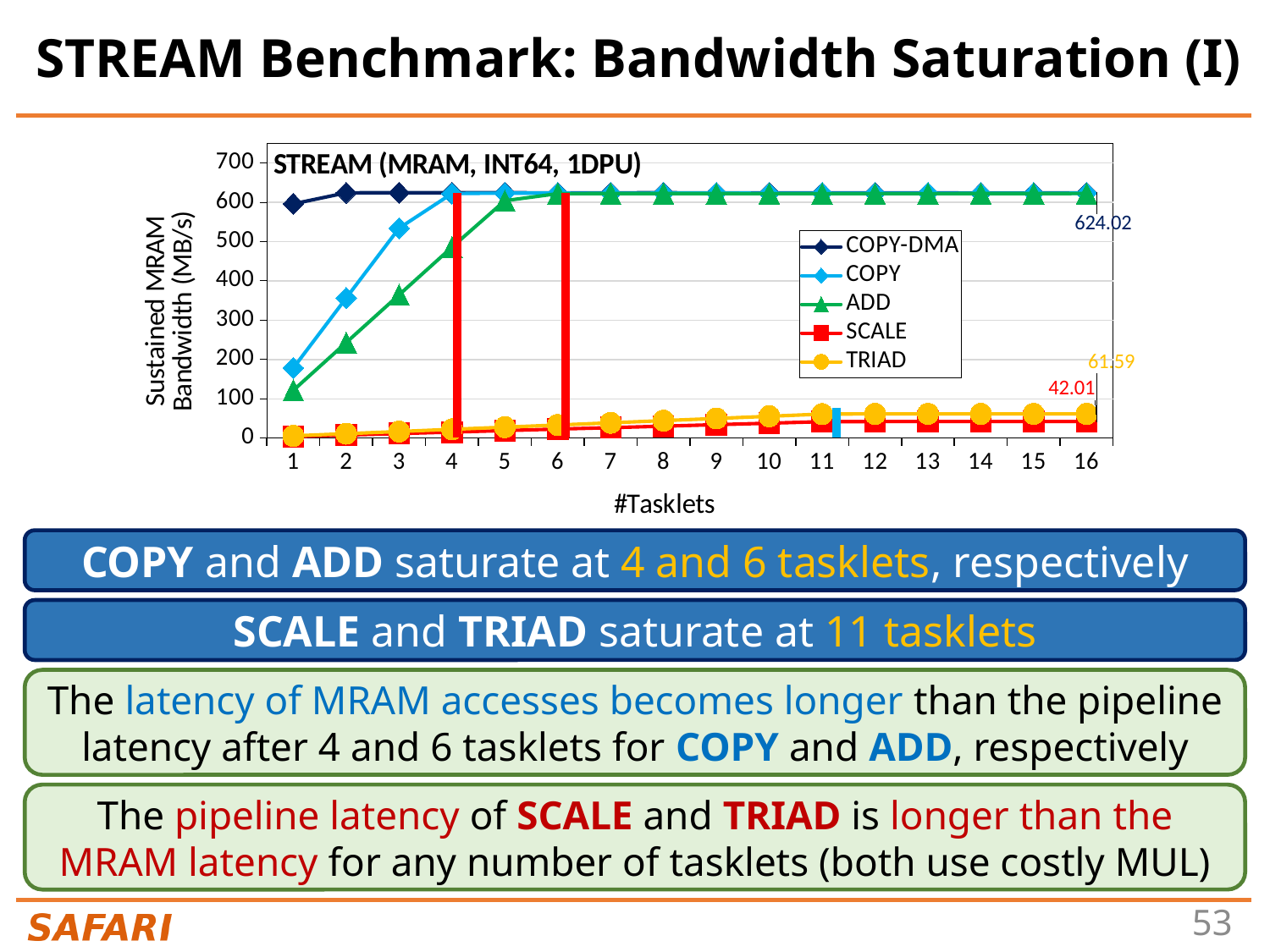
Is the value for COPY at 1 tasklet greater or less than 100? greater How many series does the chart legend list? 5 What is the labeled value of SCALE at 16 tasklets? 42.01 How many tasklet values are plotted along the x axis? 16 At 2 tasklets, which series has the higher bandwidth, COPY or ADD? COPY Which series has the lowest bandwidth at 16 tasklets? SCALE What is the labeled value of TRIAD at 16 tasklets? 61.59 What is the difference between the labeled TRIAD and SCALE values at 16 tasklets? 19.58 What type of chart is shown on the slide? line chart What is the labeled value of COPY-DMA at 16 tasklets? 624.02 What is the title shown inside the chart area? STREAM (MRAM, INT64, 1DPU)